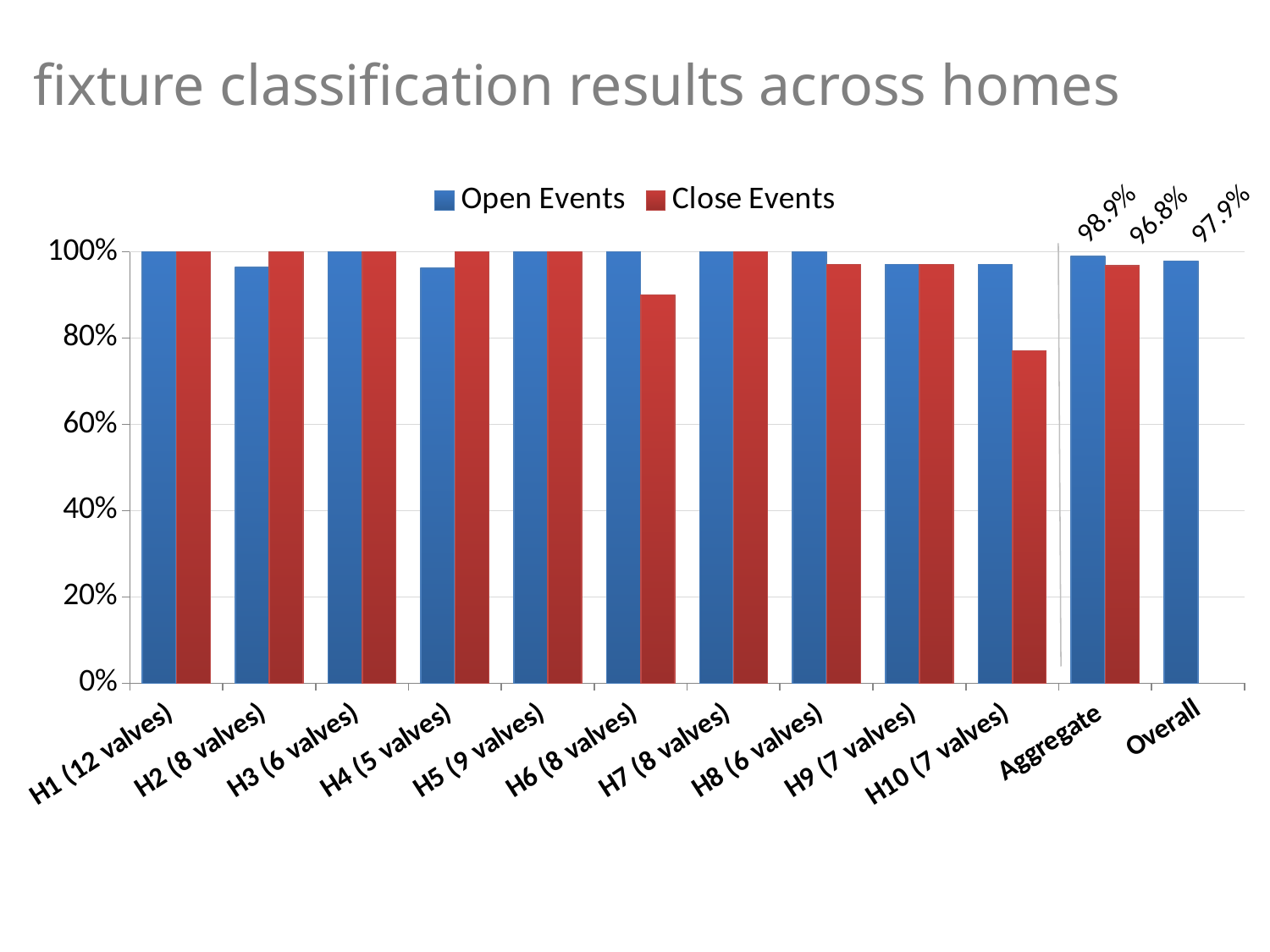
What is the Open Events value for H1 (12 valves)? 100% What is the value shown for Overall? 97.9% Is the Close Events value for H6 (8 valves) greater or less than 80%? greater What is the Open Events value for Aggregate? 98.9% How many series does the legend list? 2 For H6 (8 valves), which is larger: Open Events or Close Events? Open Events What kind of chart is shown on the slide? bar chart How many categories are shown on the x axis? 12 What is the Close Events value for Aggregate? 96.8% What is the difference between the Open Events and Close Events values for Aggregate? 2.1% Is the Close Events value for H10 (7 valves) greater or less than 80%? less Which home has the lowest Close Events value? H10 (7 valves)